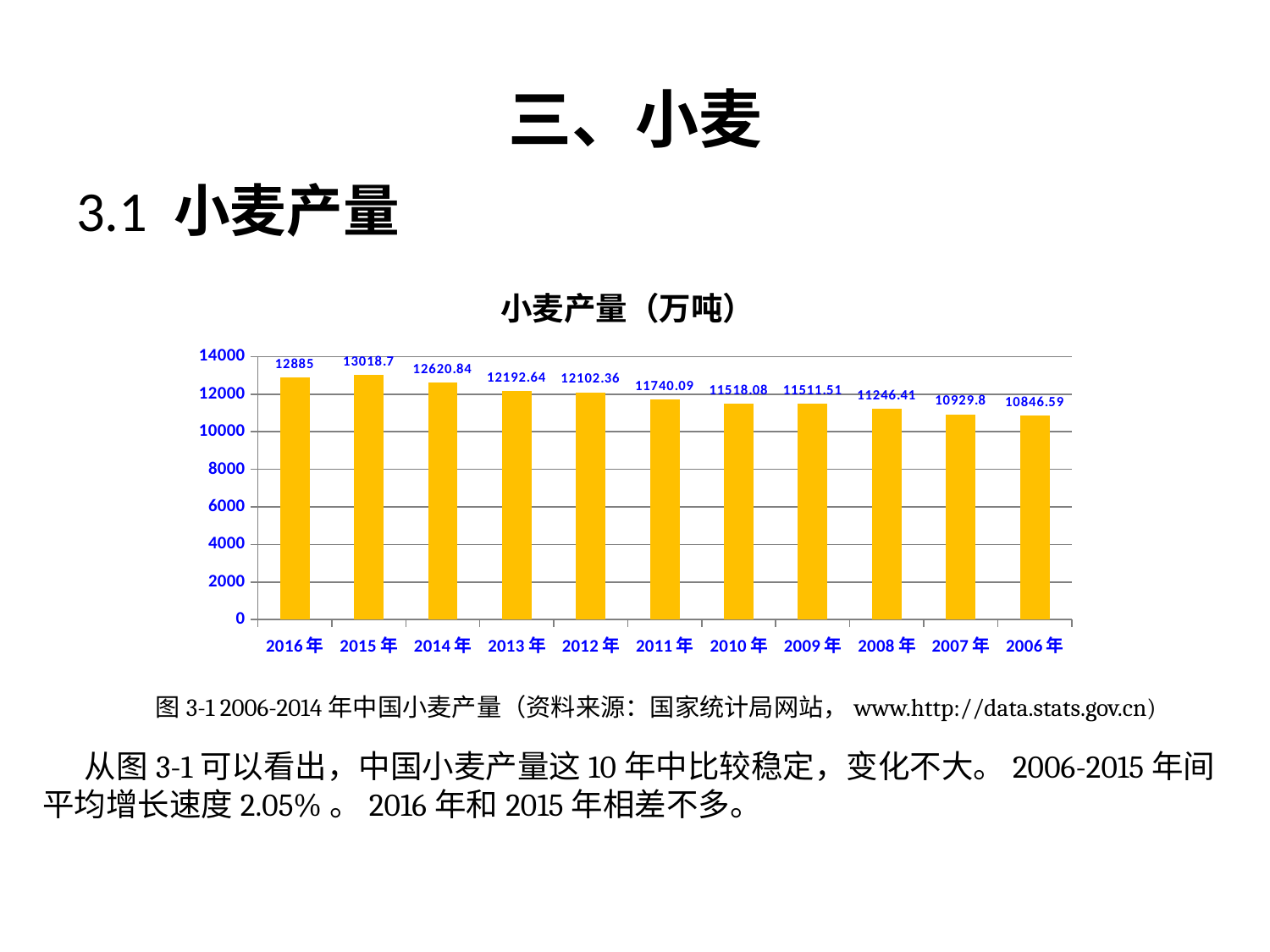
Which year has a larger wheat output, 2014年 or 2013年? 2014年 Do the bar values generally rise or fall from left to right along the x axis? fall What is the difference between the wheat output in 2007年 and 2006年? 83.21 Is the value for 2011年 greater or less than 10000? greater What type of chart is shown on the slide? bar chart What is the wheat output (小麦产量) for 2016年? 12885 What is the wheat output for 2013年? 12192.64 What is the difference between the wheat output in 2015年 and 2016年? 133.7 How many years are shown on the x axis of the chart? 11 Which year has the highest wheat output? 2015年 Which year has the lowest wheat output? 2006年 What is the wheat output for 2008年? 11246.41